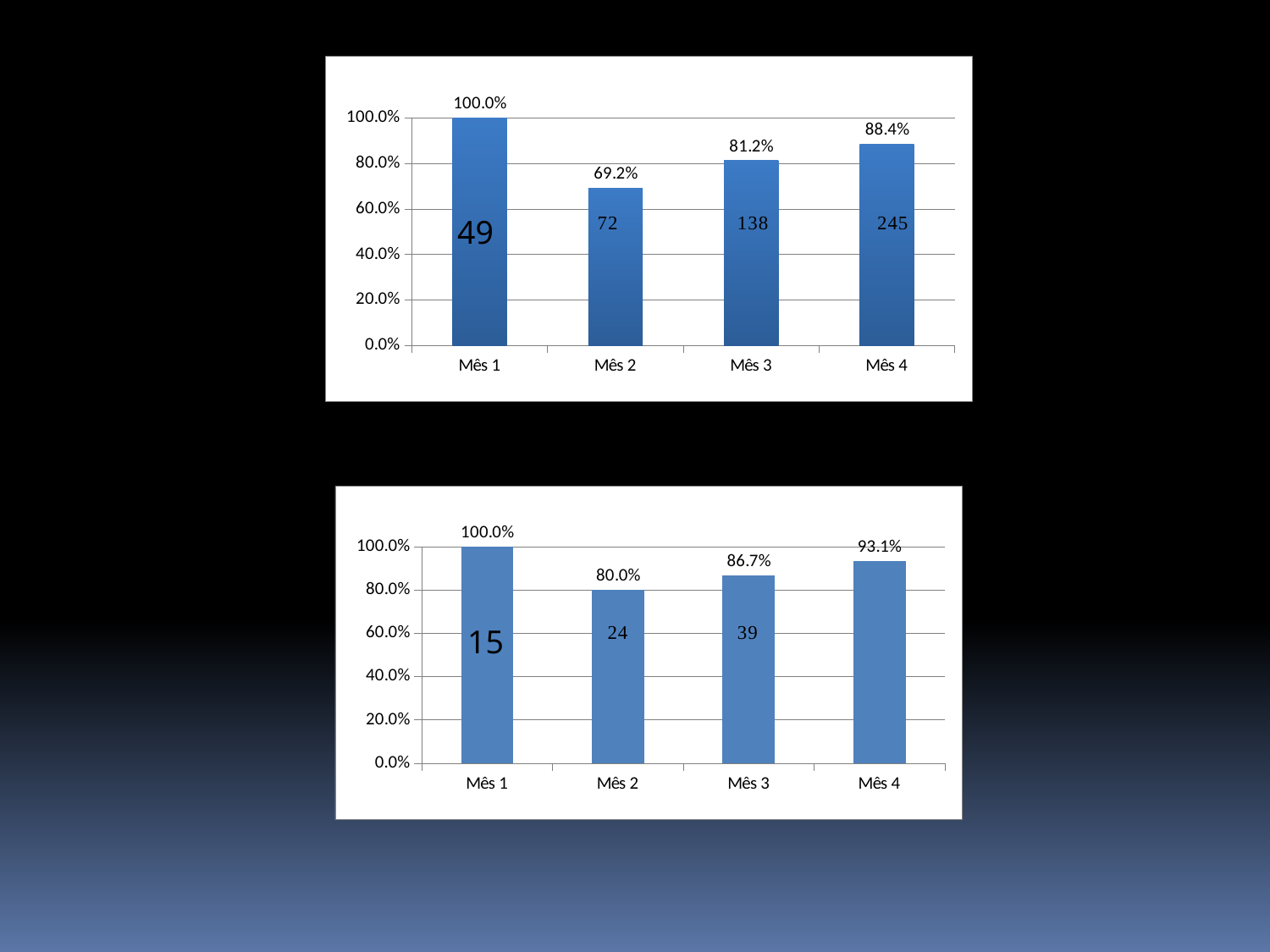
In the top chart, what number is printed inside the bar for Mês 3? 138 In the bottom chart, what is the percentage value shown for Mês 4? 93.1% In the bottom chart, what is the difference between the percentage for Mês 1 and the percentage for Mês 2? 20.0% In the bottom chart, what is the percentage value shown for Mês 3? 86.7% In the top chart, which month has the lowest percentage? Mês 2 In the bottom chart, which is larger, the percentage for Mês 2 or the percentage for Mês 3? Mês 3 In the bottom chart, which month has the highest percentage? Mês 1 How many categories are shown on the x axis of the bottom chart? 4 In the top chart, what is the percentage value shown for Mês 4? 88.4% What kind of chart is the top chart? Bar chart In the top chart, what is the percentage value shown for Mês 2? 69.2% In the top chart, what is the difference between the percentage for Mês 4 and the percentage for Mês 3? 7.2%